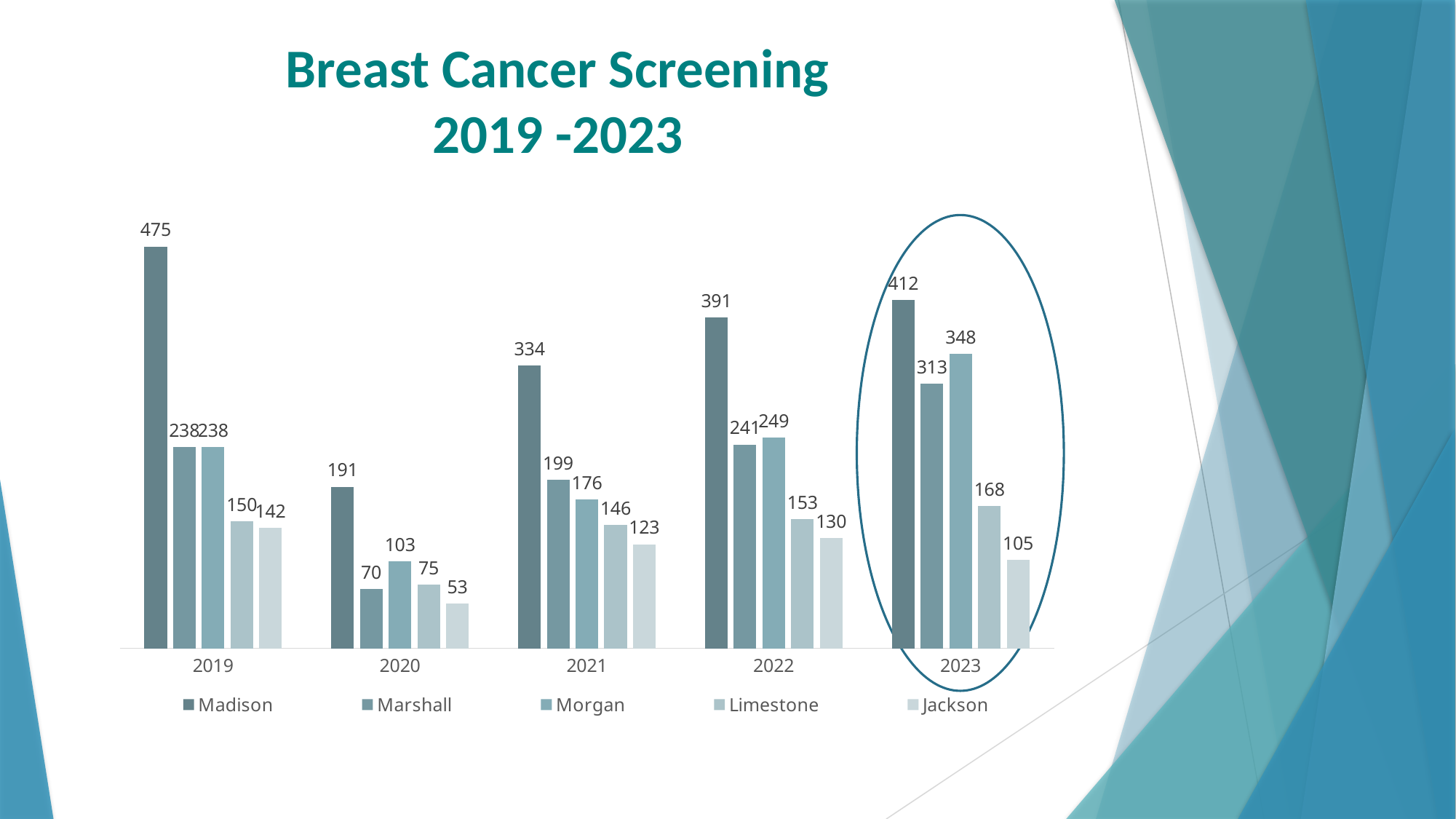
What is the difference between Madison's value in 2019 and its value in 2020? 284 Which county has the highest value in 2021? Madison Which is larger in 2023, Marshall or Morgan? Morgan What is the value for Jackson in 2020? 53 How many years are shown on the x axis? 5 What is the value for Morgan in 2023? 348 What is the value for Madison in 2019? 475 Which county has the lowest value in 2023? Jackson Which year on the chart is circled? 2023 How many series does the legend list? 5 What is the value for Limestone in 2022? 153 What kind of chart is shown on the slide? Bar chart